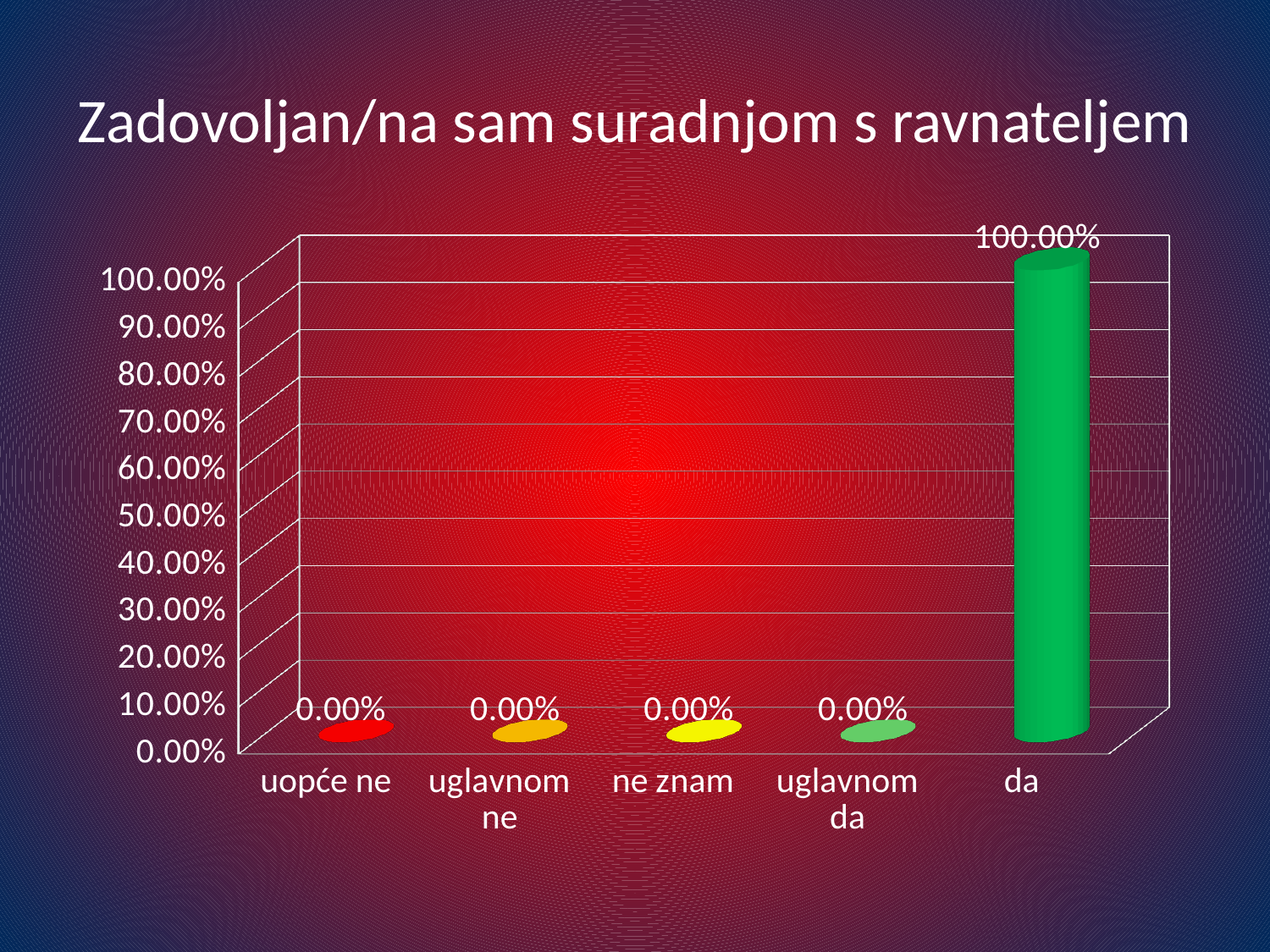
Is the value for "da" greater or less than 50.00%? greater What is the value for "uglavnom da"? 0.00% What is the value for "uopće ne"? 0.00% What kind of chart is shown on the slide? bar chart How many categories are shown on the x axis? 5 What is the value for "ne znam"? 0.00% What is the title of the chart? Zadovoljan/na sam suradnjom s ravnateljem What is the difference between the values for "da" and "uglavnom da"? 100.00% Which is larger, the value for "da" or the value for "uglavnom ne"? da What is the value for "da"? 100.00% Which category has the highest value? da What colour is the bar for "da"? green